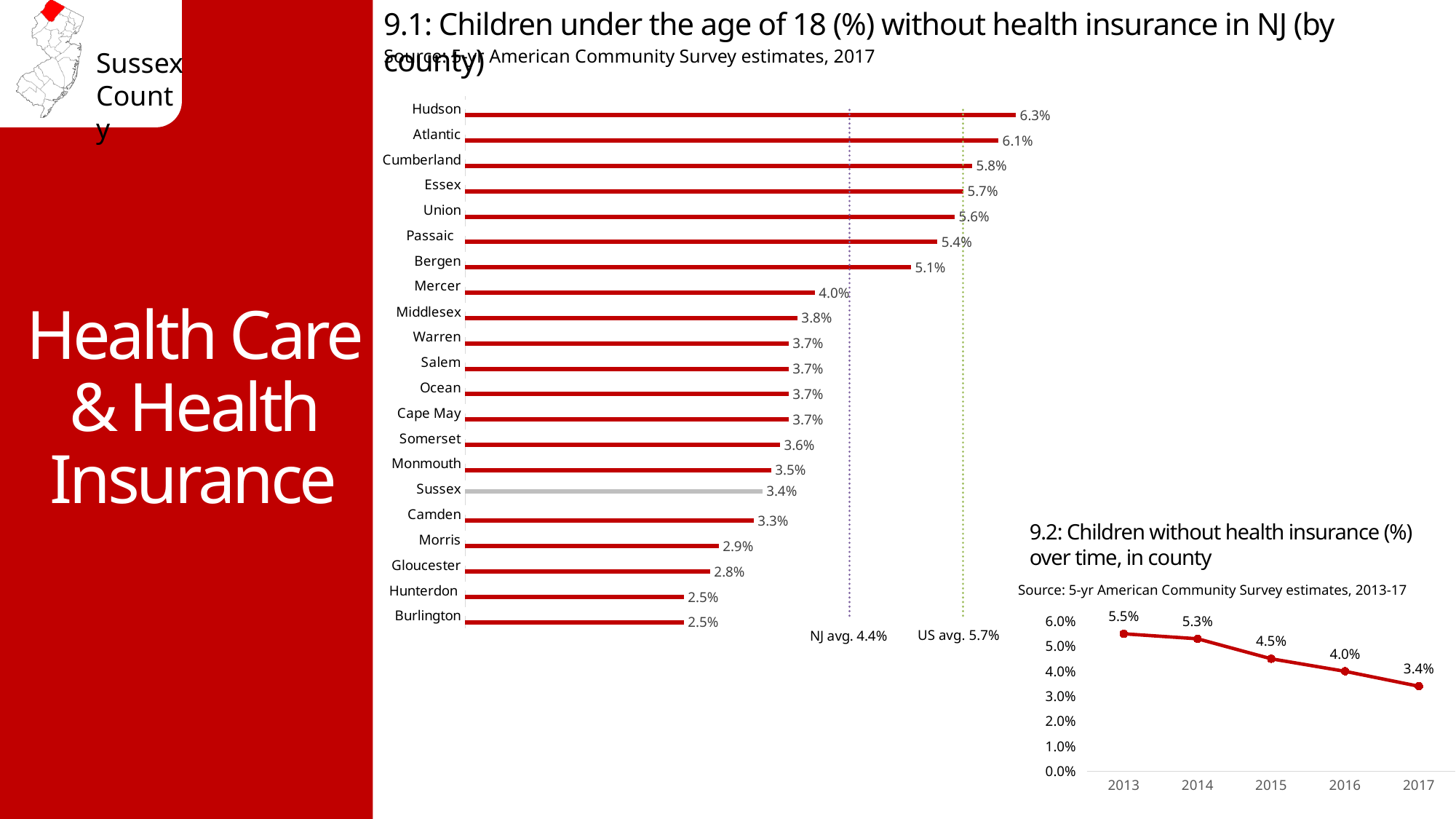
In chart 9.1 (children under 18 without health insurance by county), which county has the highest value? Hudson In chart 9.2 (children without health insurance over time), do the values rise or fall from 2013 to 2017? Fall In chart 9.1 (children under 18 without health insurance by county), what is the value for Sussex? 3.4% In chart 9.2 (children without health insurance over time), what is the value for 2015? 4.5% In chart 9.1 (children under 18 without health insurance by county), which is larger, Passaic or Mercer? Passaic In chart 9.1 (children under 18 without health insurance by county), what NJ average is marked by the dotted line? 4.4% In chart 9.1 (children under 18 without health insurance by county), what is the value for Bergen? 5.1% In chart 9.1 (children under 18 without health insurance by county), what is the difference between Hudson and Sussex? 2.9% In chart 9.2 (children without health insurance over time), how many years are plotted? 5 In chart 9.2 (children without health insurance over time), what is the difference between 2013 and 2017? 2.1% In chart 9.1 (children under 18 without health insurance by county), what kind of chart is shown? Bar chart In chart 9.1 (children under 18 without health insurance by county), how many counties are plotted? 21